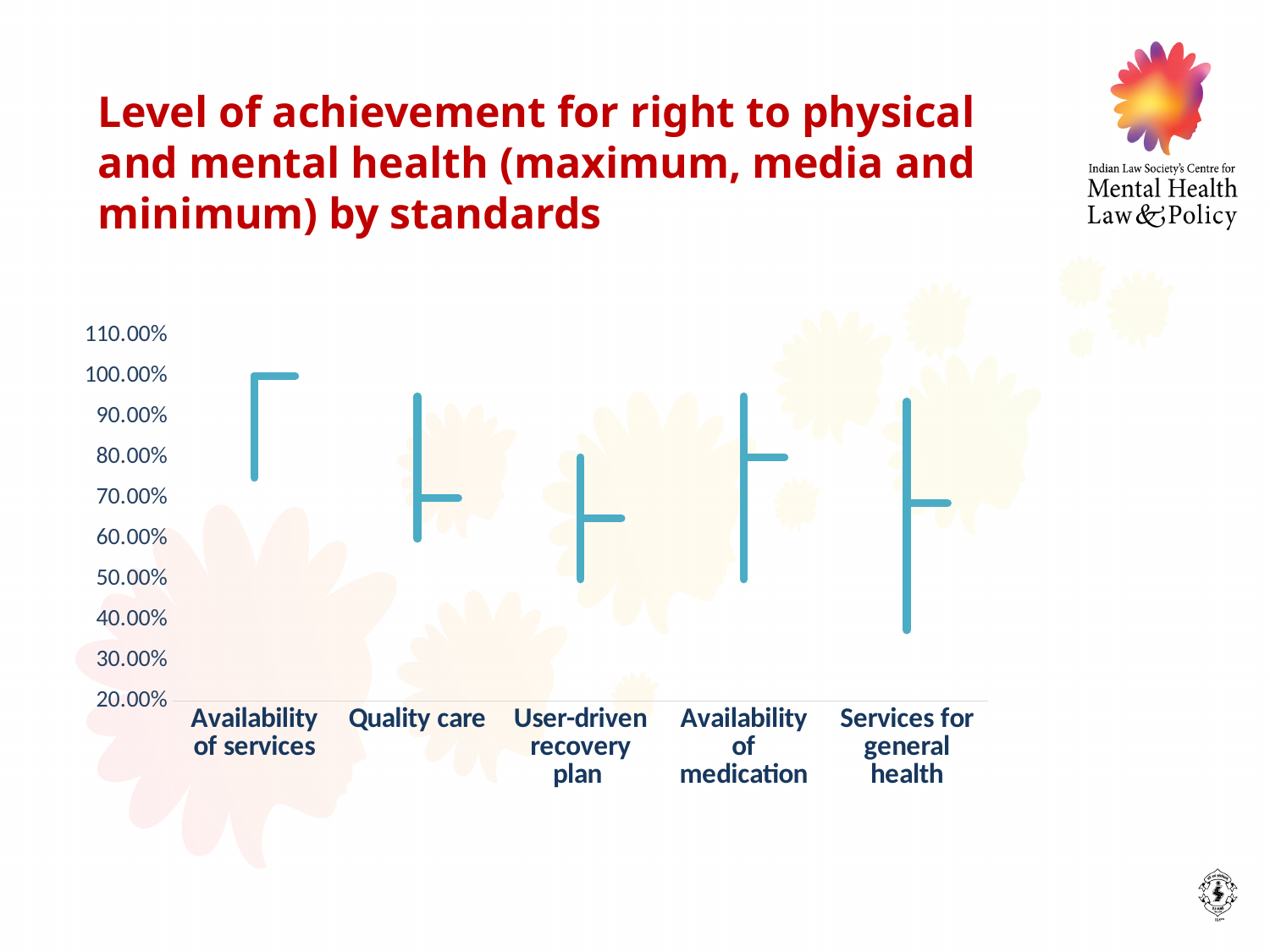
Which standard has the lowest minimum value in the chart? Services for general health What is the title of the chart on the slide? Level of achievement for right to physical and mental health (maximum, media and minimum) by standards Which standard has the highest median value in the chart? Availability of services What kind of chart is shown on the slide? stock (high-low) chart Which standard has the highest maximum value in the chart? Availability of services How many standards (categories) are shown on the x axis of the chart? 5 What is the highest tick label shown on the y axis of the chart? 110.00% Is the minimum value for Services for general health greater or less than 50.00%? less Is the maximum value for Availability of services greater or less than 90.00%? greater Is the median value for User-driven recovery plan greater or less than 70.00%? less Which has the larger median value: Availability of medication or Quality care? Availability of medication